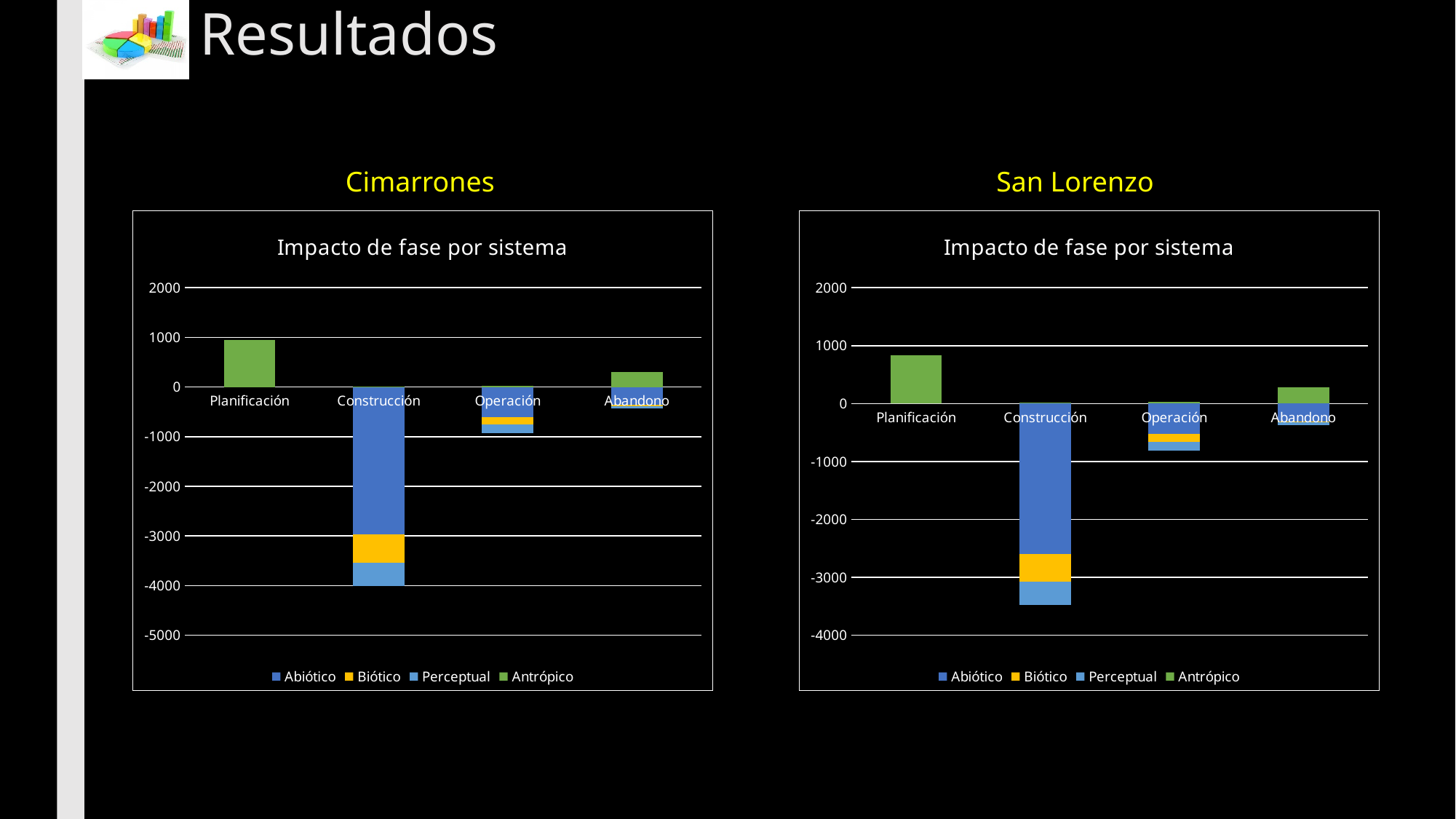
In the Cimarrones chart, which category has the largest positive Antrópico value? Planificación In the San Lorenzo chart, is the Abiótico value for Construcción greater or less than -2000? less How many series does the legend of the Cimarrones chart list? 4 What type of chart is the Cimarrones chart? Stacked bar chart What is the title of the San Lorenzo chart? Impacto de fase por sistema In the San Lorenzo chart, which category has the largest negative stacked total? Construcción In the Cimarrones chart, which is larger: the Antrópico value for Planificación or the Antrópico value for Abandono? Planificación How many categories are shown on the x axis of the San Lorenzo chart? 4 In the San Lorenzo chart, which series is shown in yellow? Biótico In the Cimarrones chart, is the Abiótico value for Construcción greater or less than -2000? less In the San Lorenzo chart, is the Antrópico value for Planificación greater or less than 500? greater